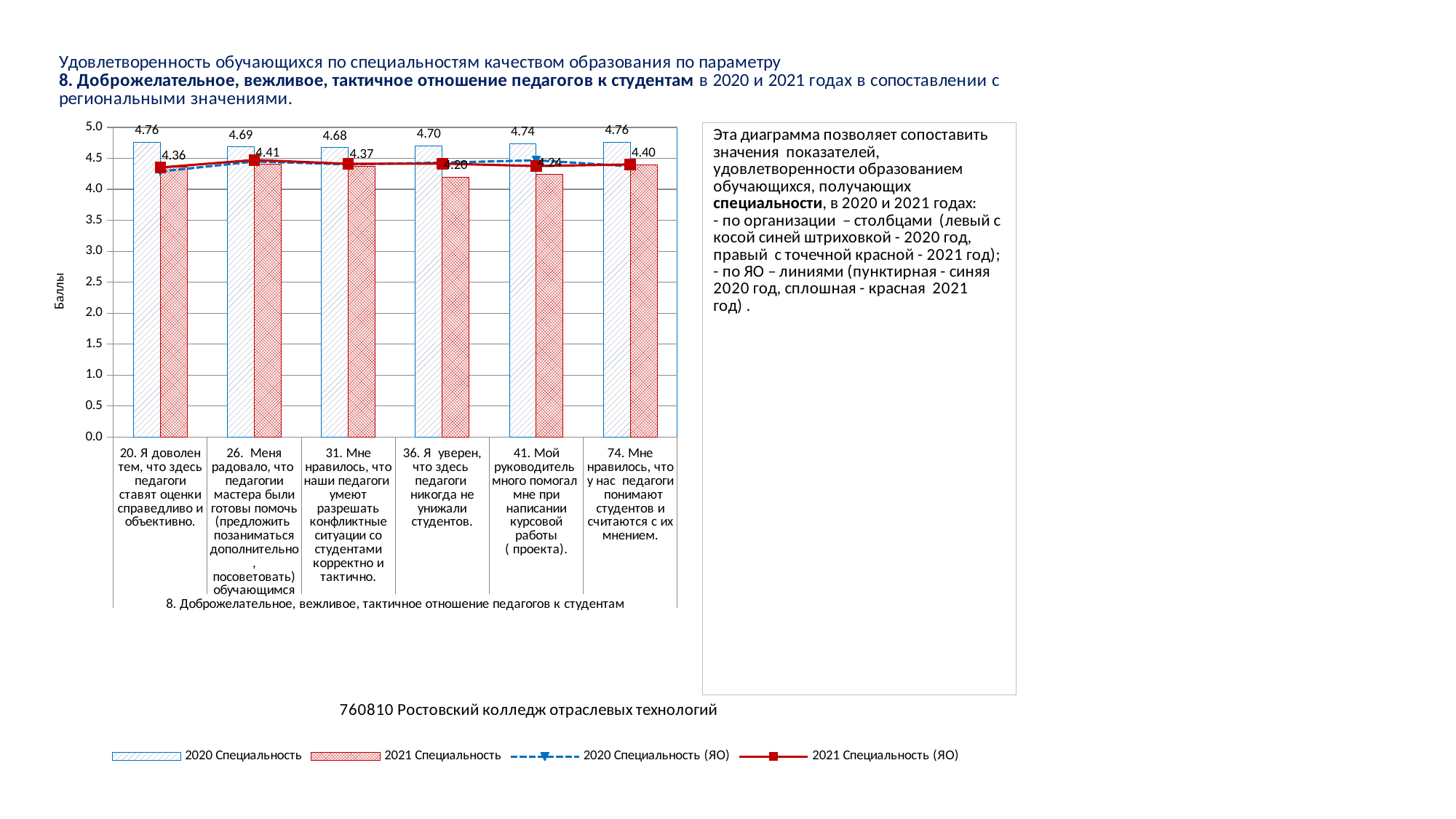
For category 36, which is larger: the 2020 Специальность value or the 2021 Специальность value? 2020 Специальность What is the value of the 2021 Специальность bar for category 26 (Меня радовало, что педагоги и мастера были готовы помочь...)? 4.41 What is the value of the 2020 Специальность bar for category 41 (Мой руководитель много помогал мне при написании курсовой работы)? 4.74 How many series does the chart legend list? 4 Is the 2021 Специальность (ЯО) line value for category 20 greater or less than 4.0? greater What is the title of the vertical axis of the chart? Баллы What is the difference between the 2020 Специальность and 2021 Специальность values for category 20? 0.40 What is the difference between the 2020 Специальность and 2021 Специальность values for category 31? 0.31 Which category has the lowest 2021 Специальность value? 36. Я уверен, что здесь педагоги никогда не унижали студентов. What is the value of the 2021 Специальность bar for category 74 (Мне нравилось, что у нас педагоги понимают студентов и считаются с их мнением)? 4.40 How many categories (questions) are shown on the x axis of the chart? 6 What is the value of the 2020 Специальность bar for category 20 (Я доволен тем, что здесь педагоги ставят оценки справедливо и объективно)? 4.76